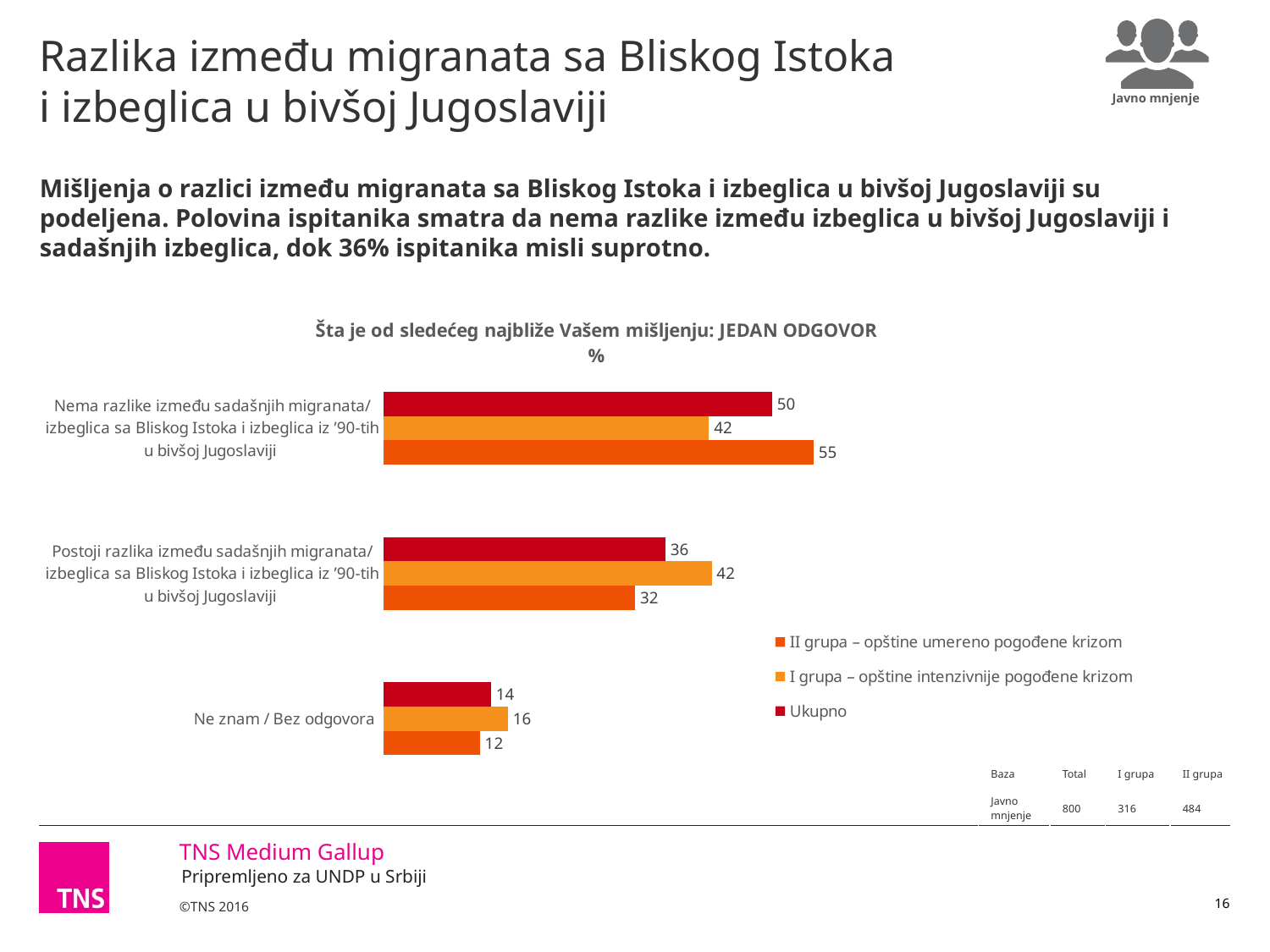
What is the II grupa value for 'Nema razlike između sadašnjih migranata/izbeglica sa Bliskog Istoka i izbeglica iz '90-tih u bivšoj Jugoslaviji'? 55 What kind of chart is shown on the slide? bar chart How many categories are shown on the chart? 3 Which category has the highest II grupa value? Nema razlike između sadašnjih migranata/izbeglica sa Bliskog Istoka i izbeglica iz '90-tih u bivšoj Jugoslaviji What is the I grupa value for 'Postoji razlika između sadašnjih migranata/izbeglica sa Bliskog Istoka i izbeglica iz '90-tih u bivšoj Jugoslaviji'? 42 What is the Ukupno value for 'Ne znam / Bez odgovora'? 14 Which category has the lowest Ukupno value? Ne znam / Bez odgovora What is the title of the chart? Šta je od sledećeg najbliže Vašem mišljenju: JEDAN ODGOVOR % How many series does the chart legend list? 3 What is the Ukupno value for 'Nema razlike između sadašnjih migranata/izbeglica sa Bliskog Istoka i izbeglica iz '90-tih u bivšoj Jugoslaviji'? 50 For 'Postoji razlika između sadašnjih migranata/izbeglica sa Bliskog Istoka i izbeglica iz '90-tih u bivšoj Jugoslaviji', which is larger: the I grupa value or the II grupa value? I grupa What is the difference between the II grupa and I grupa values for 'Nema razlike između sadašnjih migranata/izbeglica sa Bliskog Istoka i izbeglica iz '90-tih u bivšoj Jugoslaviji'? 13